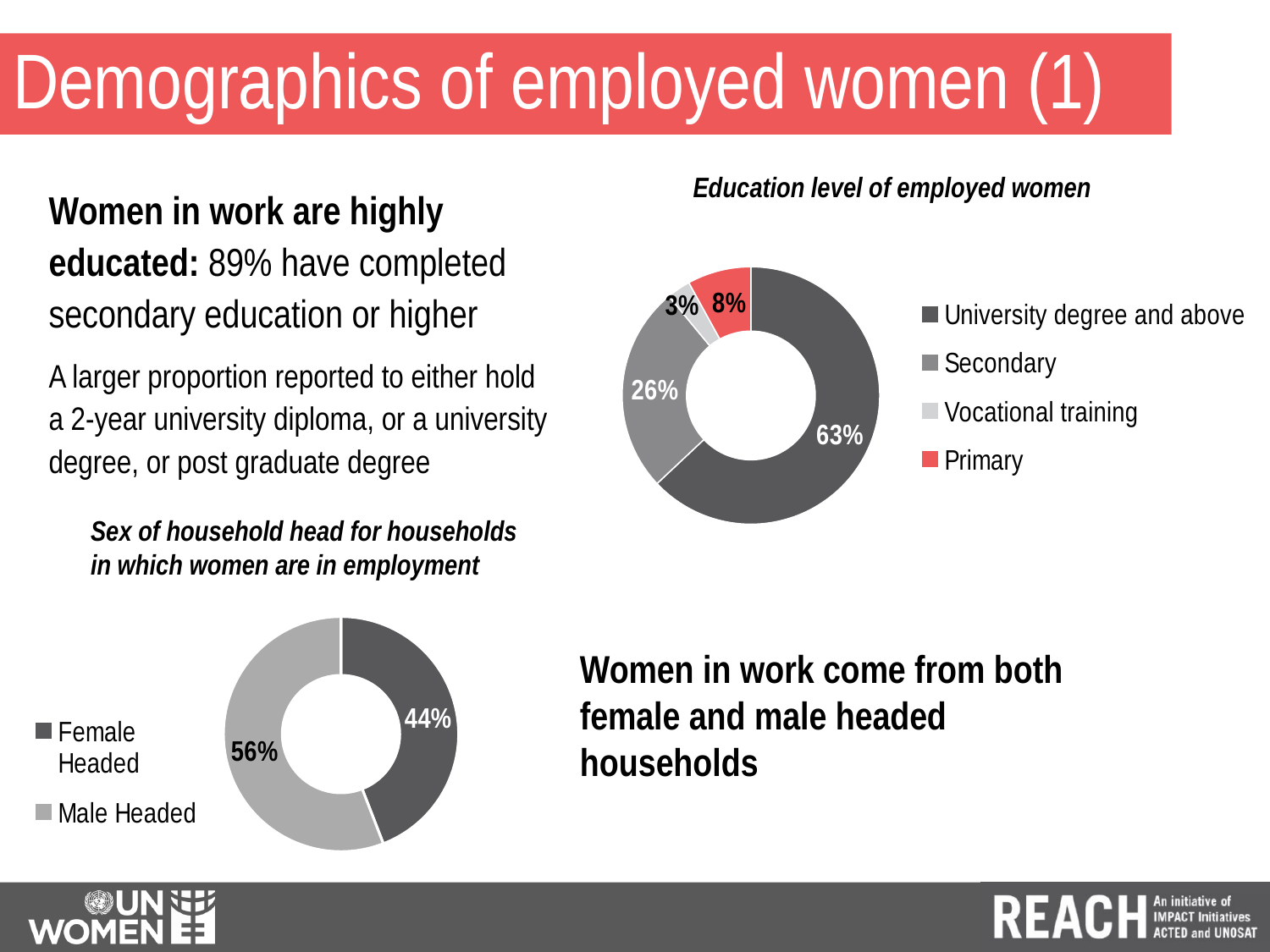
In the 'Sex of household head' chart, which is larger: Female Headed or Male Headed? Male Headed In the 'Sex of household head' chart, what percentage of households are male headed? 56% In the 'Education level of employed women' chart, which category is shown in red? Primary In the 'Education level of employed women' chart, which education level has the smallest share? Vocational training In the 'Education level of employed women' chart, what percentage of employed women have secondary education? 26% In the 'Education level of employed women' chart, what percentage of employed women have primary education? 8% In the 'Education level of employed women' chart, which education level has the largest share? University degree and above In the 'Education level of employed women' chart, what percentage of employed women have a university degree and above? 63% What type of chart is the 'Sex of household head for households in which women are in employment' chart? Doughnut (pie) chart In the 'Education level of employed women' chart, what is the difference in percentage points between University degree and above and Secondary? 37 In the 'Education level of employed women' chart, what percentage of employed women have vocational training? 3% In the 'Education level of employed women' chart, how many categories does the legend list? 4